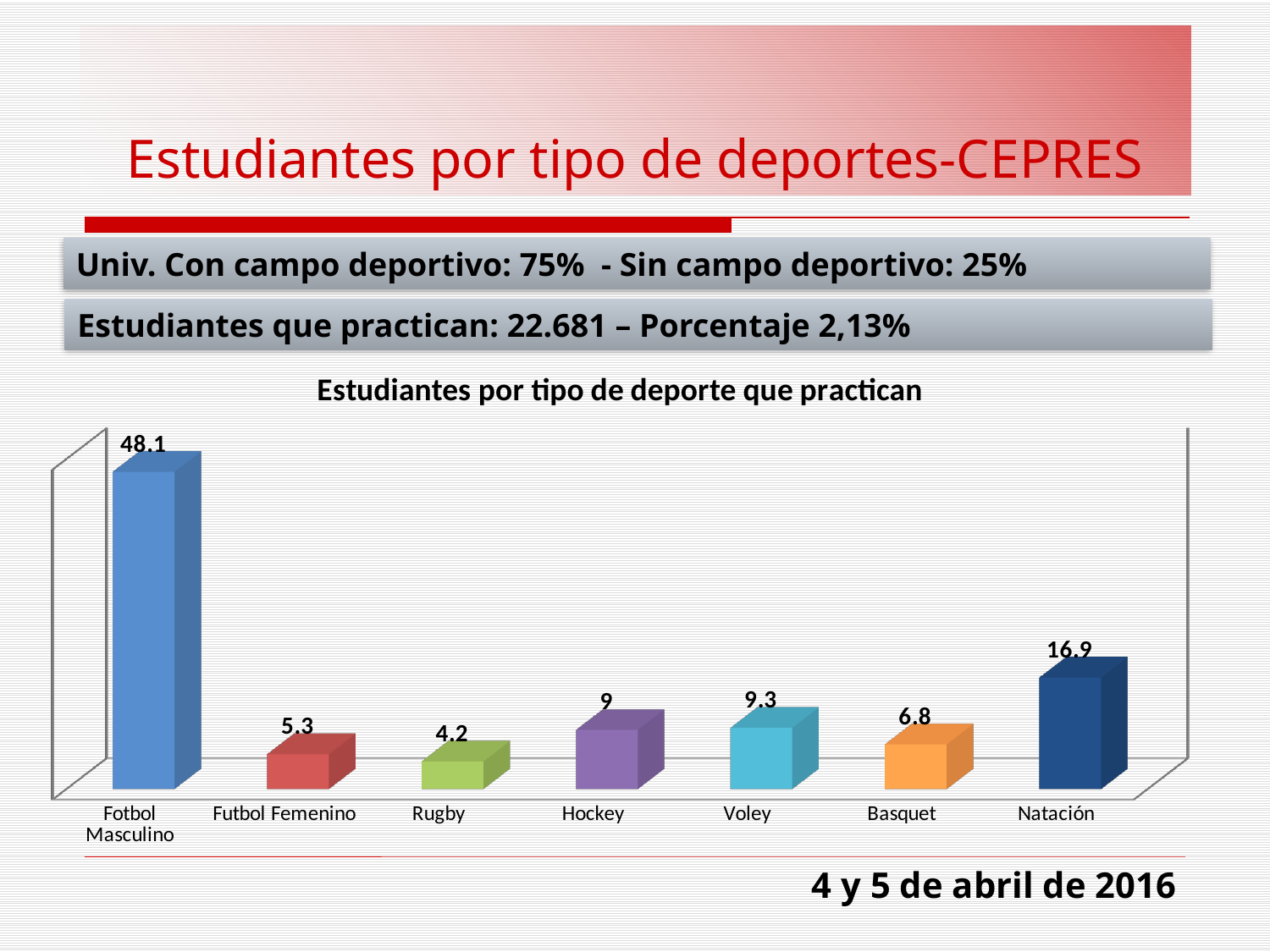
What is the value for Basquet? 6.8 Which is larger, the value for Voley or the value for Basquet? Voley What is the title of the chart? Estudiantes por tipo de deporte que practican What is the value for Natación? 16.9 What is the difference between the values for Fotbol Masculino and Natación? 31.2 Which sport has the lowest value? Rugby What is the value for Fotbol Masculino? 48.1 Which sport has the highest value? Fotbol Masculino What kind of chart is shown on the slide? Bar chart What is the difference between the values for Futbol Femenino and Rugby? 1.1 How many sport categories are shown in the chart? 7 What is the value for Hockey? 9